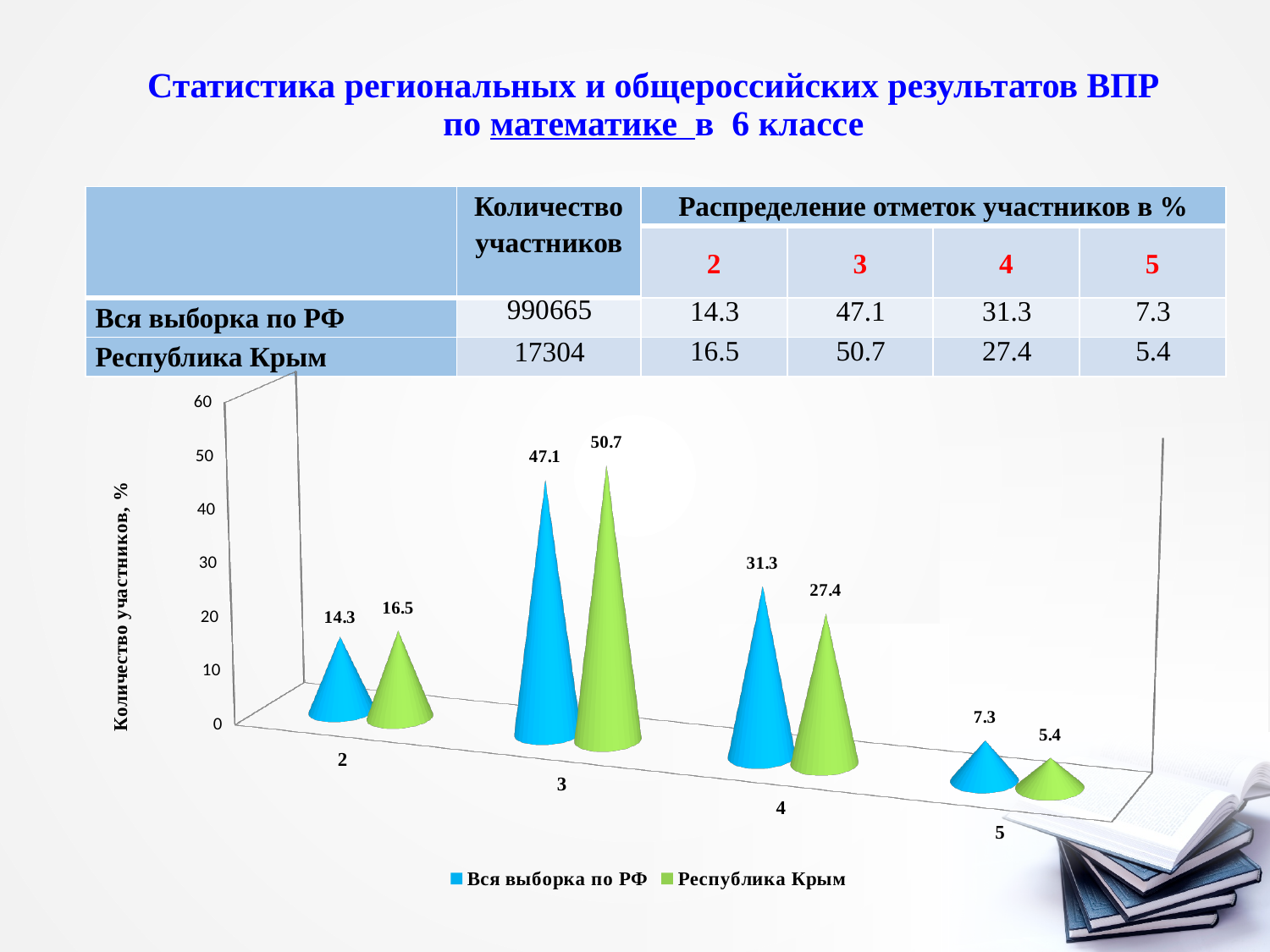
What is the value for Республика Крым at grade 3? 50.7 Which grade category has the highest value for Республика Крым? 3 What kind of chart is shown on the slide? bar chart What is the difference between Вся выборка по РФ and Республика Крым at grade 4? 3.9 What is the label of the vertical axis? Количество участников, % What is the difference between Республика Крым and Вся выборка по РФ at grade 2? 2.2 Which is larger at grade 5: Вся выборка по РФ or Республика Крым? Вся выборка по РФ How many grade categories are shown on the x axis? 4 Which grade category has the lowest value for Вся выборка по РФ? 5 What is the value for Вся выборка по РФ at grade 5? 7.3 What is the value for Вся выборка по РФ at grade 4? 31.3 How many series does the legend list? 2